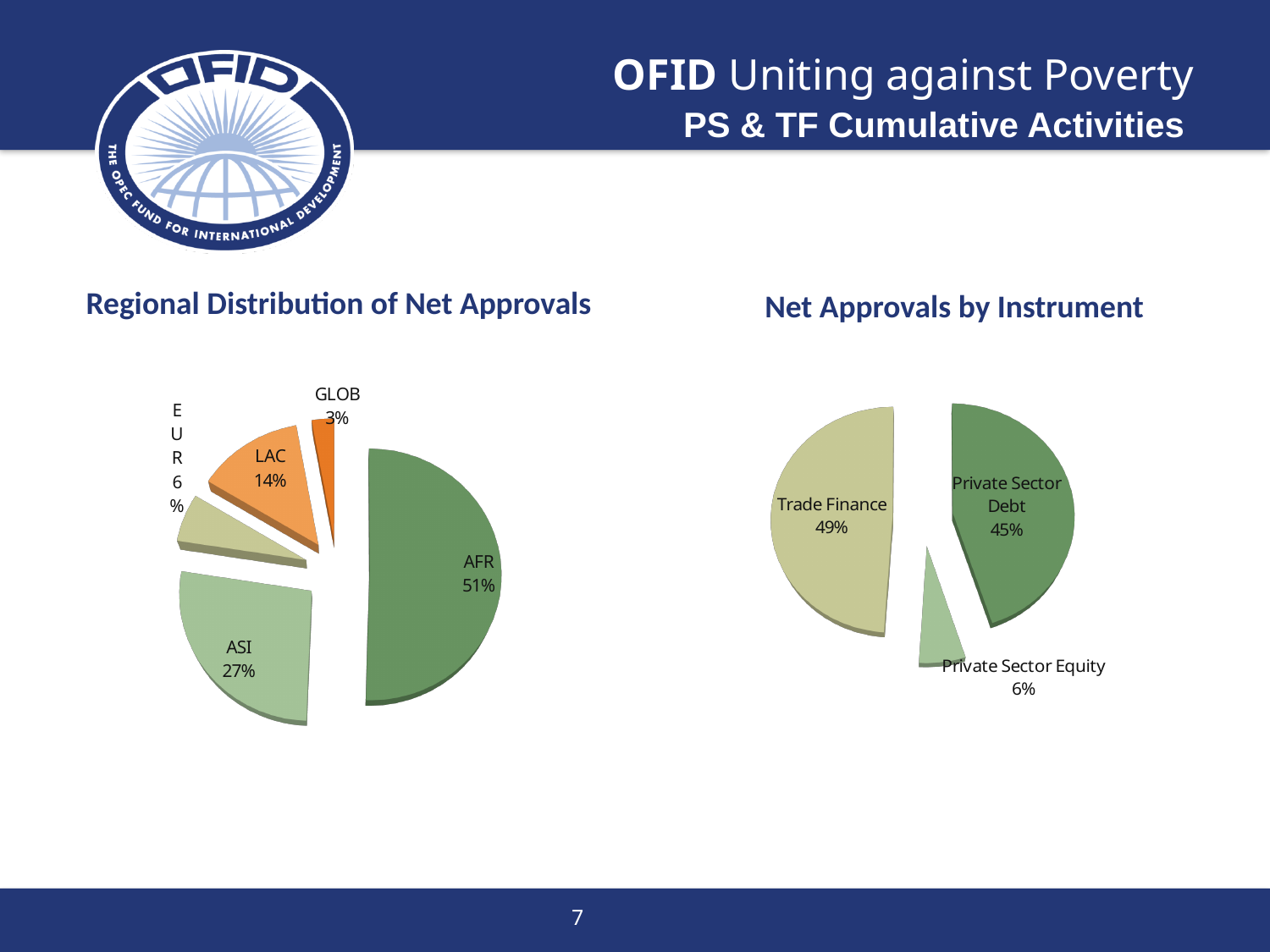
In the 'Net Approvals by Instrument' chart, what share does Trade Finance have? 49% In the 'Net Approvals by Instrument' chart, what share does Private Sector Equity have? 6% In the 'Net Approvals by Instrument' chart, how many instruments are shown? 3 In the 'Regional Distribution of Net Approvals' chart, how many regions are shown? 5 In the 'Regional Distribution of Net Approvals' chart, which region has the largest share? AFR In the 'Net Approvals by Instrument' chart, which is larger, Trade Finance or Private Sector Debt? Trade Finance In the 'Regional Distribution of Net Approvals' chart, what is the difference in percentage points between AFR and ASI? 24 In the 'Regional Distribution of Net Approvals' chart, what share of net approvals goes to AFR? 51% In the 'Regional Distribution of Net Approvals' chart, which region has the smallest share? GLOB In the 'Regional Distribution of Net Approvals' chart, what is the share for LAC? 14% In the 'Regional Distribution of Net Approvals' chart, what share does ASI have? 27% What type of chart is 'Net Approvals by Instrument'? Pie chart